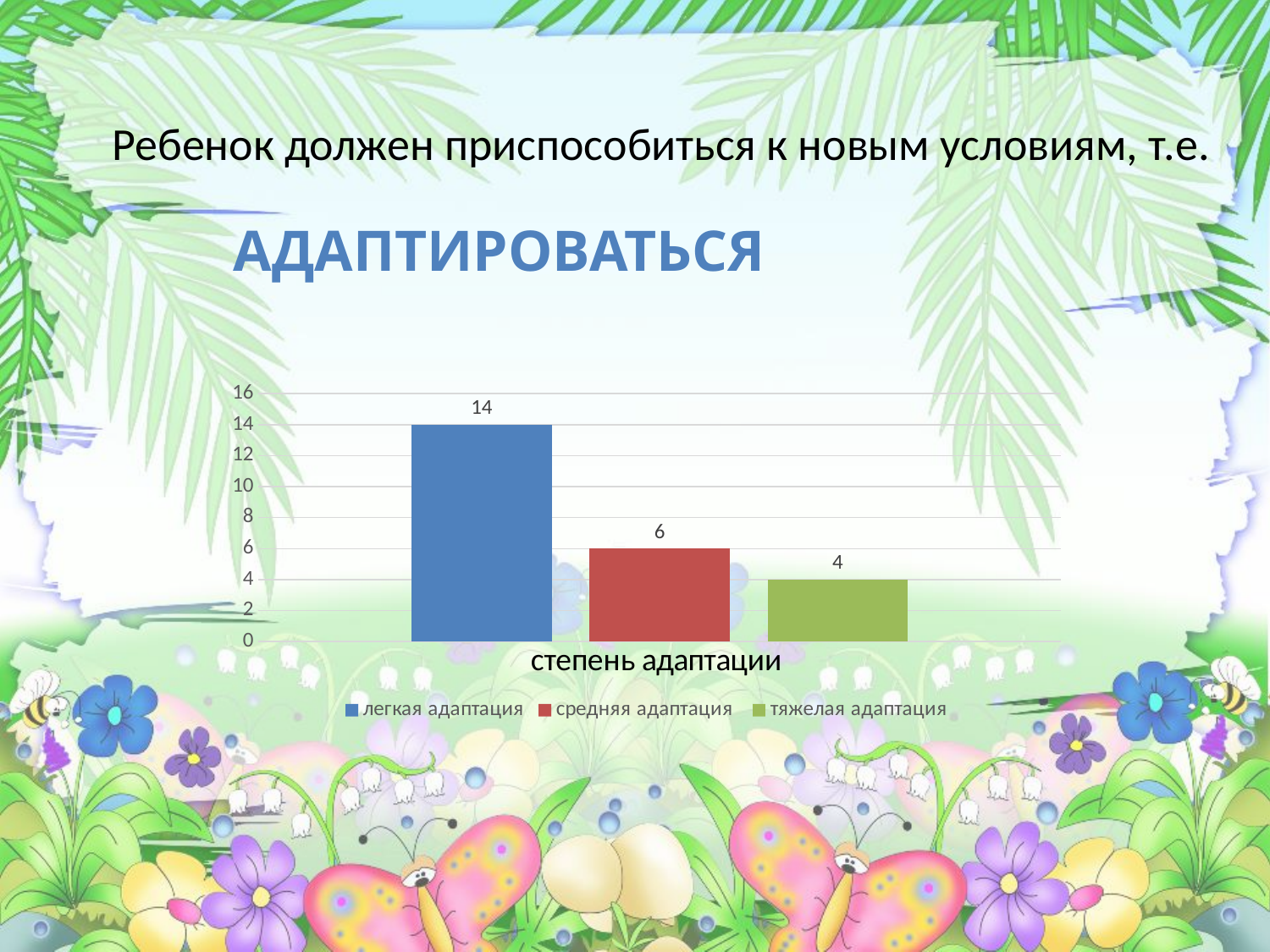
Is the value for легкая адаптация greater or less than 10? greater Which series has the lowest value? тяжелая адаптация What is the value for тяжелая адаптация? 4 Which series has the highest value? легкая адаптация What is the value for средняя адаптация? 6 What is the category label shown on the x axis of the chart? степень адаптации What kind of chart is shown on the slide? bar chart What is the difference between the values for средняя адаптация and тяжелая адаптация? 2 What is the difference between the values for легкая адаптация and средняя адаптация? 8 Which is larger, the value for средняя адаптация or the value for тяжелая адаптация? средняя адаптация How many series does the legend list? 3 What is the value for легкая адаптация? 14